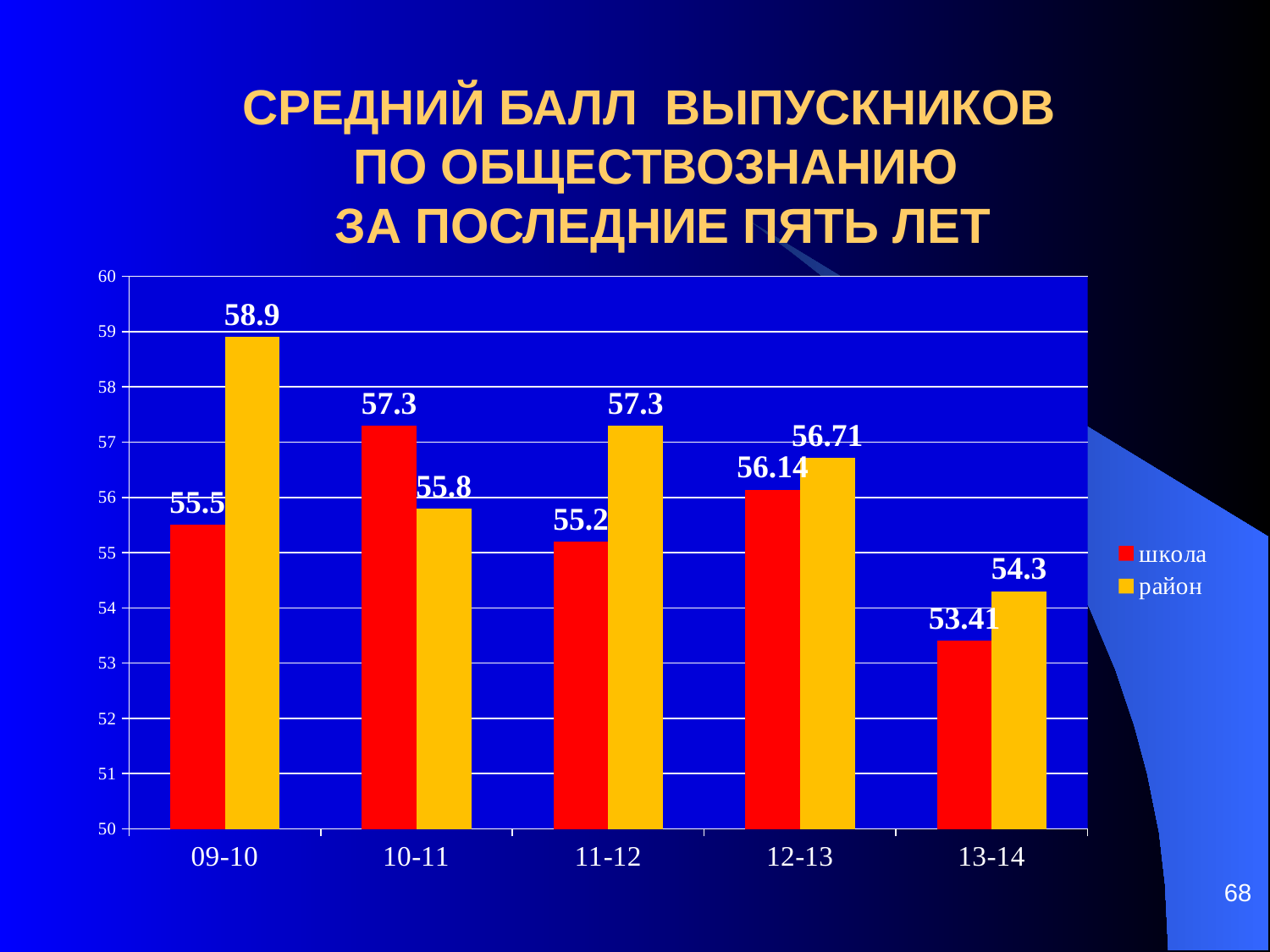
What is the value for школа in 09-10? 55.5 What is the difference between район and школа in 09-10? 3.4 Which colour represents район in the legend? yellow In which year is the район value highest? 09-10 How many series does the legend list? 2 Is the value for район in 13-14 greater or less than 55? less How many years are shown on the x axis? 5 What is the value for район in 12-13? 56.71 What is the value for школа in 13-14? 53.41 In which year is the школа value lowest? 13-14 What kind of chart is this? bar chart Which is larger in 10-11, школа or район? школа